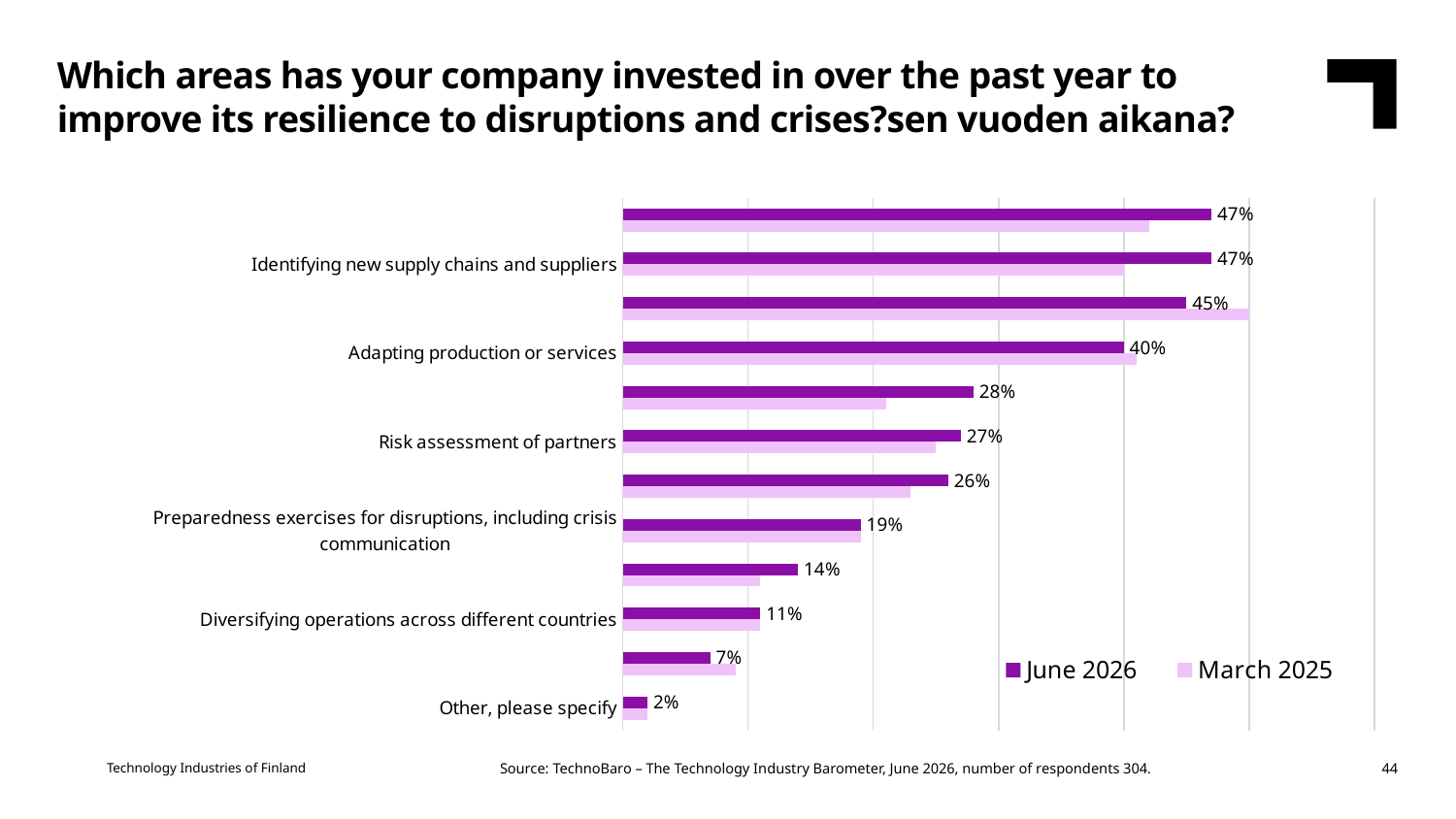
What is the difference between the June 2026 values for Adapting production or services and Risk assessment of partners? 13 percentage points What is the June 2026 value for Risk assessment of partners? 27% Which category has the lowest June 2026 value? Other, please specify What are the two series named in the legend? June 2026 and March 2025 How many series does the legend list? 2 What is the June 2026 value for Identifying new supply chains and suppliers? 47% What is the June 2026 value for Adapting production or services? 40% What is the June 2026 value for Preparedness exercises for disruptions, including crisis communication? 19% Which has a higher June 2026 value: Risk assessment of partners or Diversifying operations across different countries? Risk assessment of partners What is the June 2026 value for Other, please specify? 2% What is the June 2026 value for Diversifying operations across different countries? 11% What kind of chart is shown on the slide? Bar chart